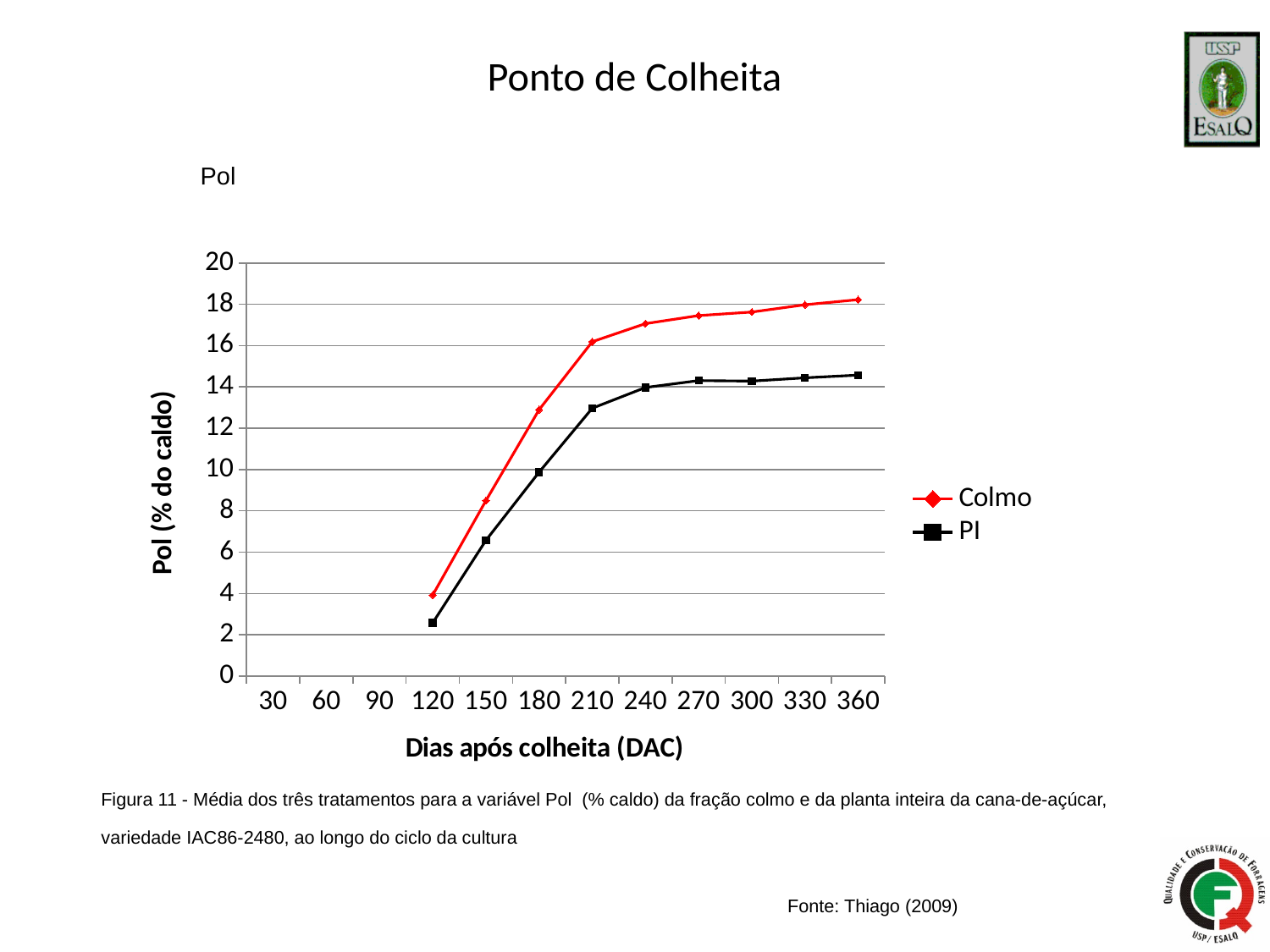
Is the value for PI at 120 DAC greater or less than 4? less Is the value for Colmo at 360 DAC greater or less than 16? greater How many series does the legend list? 2 What are the names of the two series in the legend? Colmo and PI Do the Pol values for the PI series rise or fall as DAC increases from 120 to 360? rise At which DAC value does the Colmo series reach its highest Pol? 360 How many data points are plotted for the Colmo series? 9 Is the value for PI at 360 DAC greater or less than 16? less What kind of chart is shown on the slide? line chart What is the title of the y axis? Pol (% do caldo) At 240 DAC, which series has the higher Pol value, Colmo or PI? Colmo